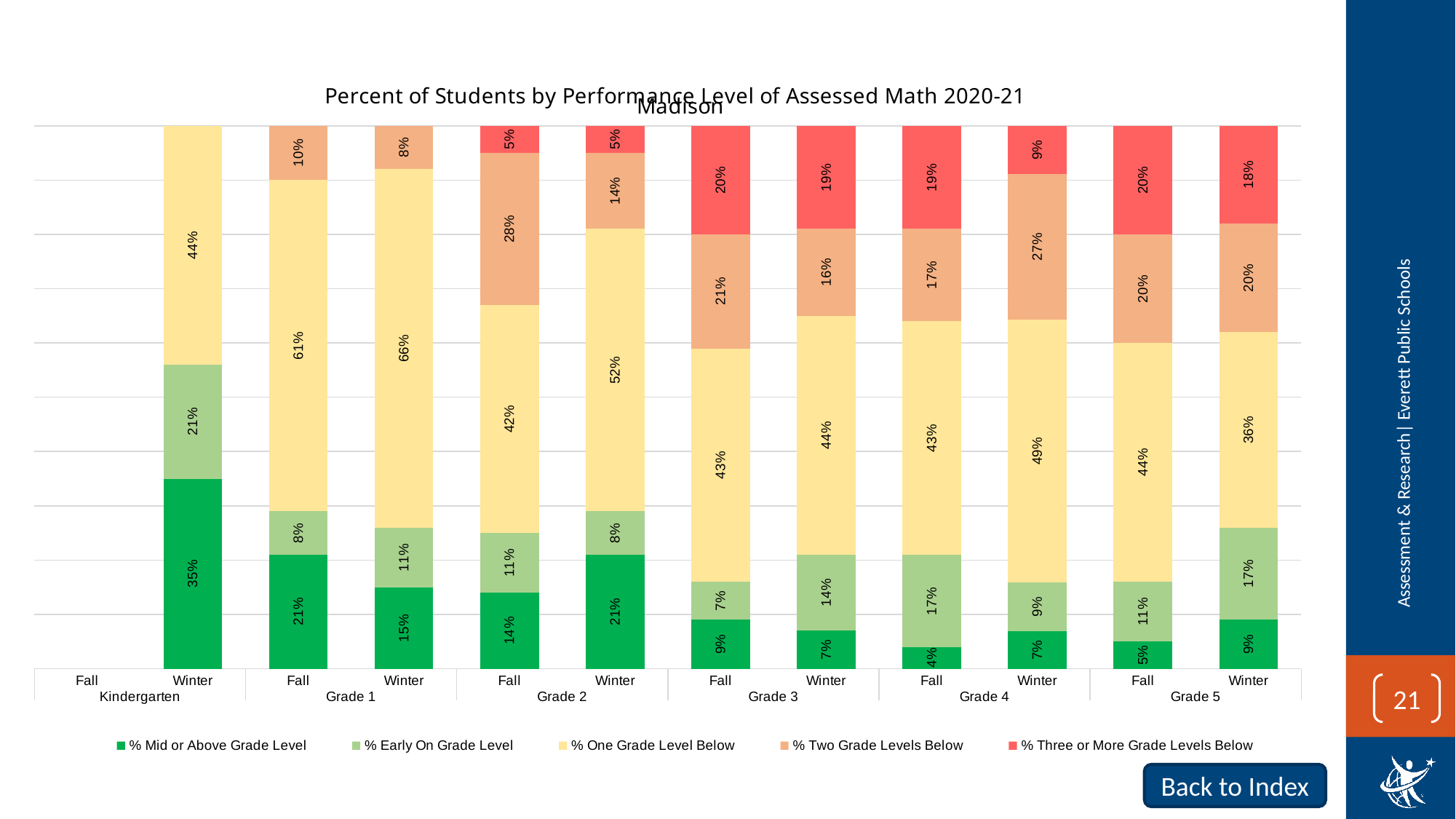
Which colour represents % Three or More Grade Levels Below in the legend? Red What percentage of Kindergarten Winter students are at % Mid or Above Grade Level? 35% What kind of chart is shown on the slide? Stacked bar chart What is the % Three or More Grade Levels Below value for Grade 5 Fall? 20% How many grade groups are shown along the x axis? 6 What is the % Two Grade Levels Below value for Grade 4 Winter? 27% What is the difference between the % One Grade Level Below values for Grade 1 Fall and Grade 2 Fall? 19% What is the % One Grade Level Below value for Grade 1 Winter? 66% Which is larger: the % Early On Grade Level value for Grade 3 Winter or for Grade 4 Winter? Grade 3 Winter How many series does the legend list? 5 Which bar has the highest % Mid or Above Grade Level value? Kindergarten Winter Which bar has the lowest % Mid or Above Grade Level value? Grade 4 Fall